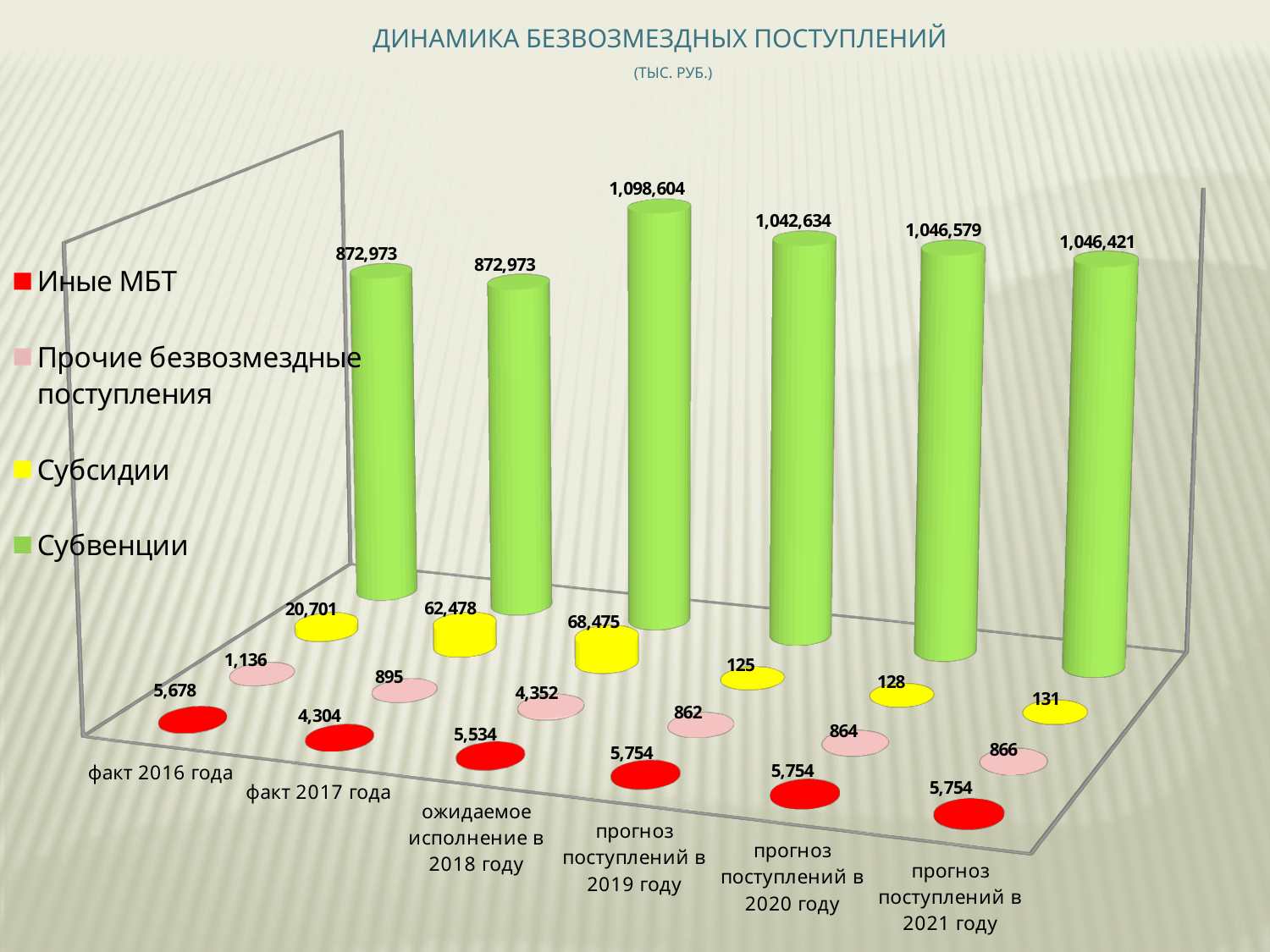
How many series does the legend list? 4 What is the value of Прочие безвозмездные поступления for прогноз поступлений в 2021 году? 866 What is the value of Субсидии for факт 2017 года? 62,478 How many categories are shown on the x axis? 6 What is the difference between the Субвенции values for ожидаемое исполнение в 2018 году and факт 2017 года? 225,631 In which category is the Субсидии value lowest? прогноз поступлений в 2019 году Which is larger: Субсидии for факт 2016 года or Субсидии for ожидаемое исполнение в 2018 году? ожидаемое исполнение в 2018 году What is the value of Иные МБТ for факт 2016 года? 5,678 What kind of chart is shown on the slide? bar chart In which category is the Субвенции value highest? ожидаемое исполнение в 2018 году What is the value of Субвенции for ожидаемое исполнение в 2018 году? 1,098,604 What colour represents Субвенции in the chart? green